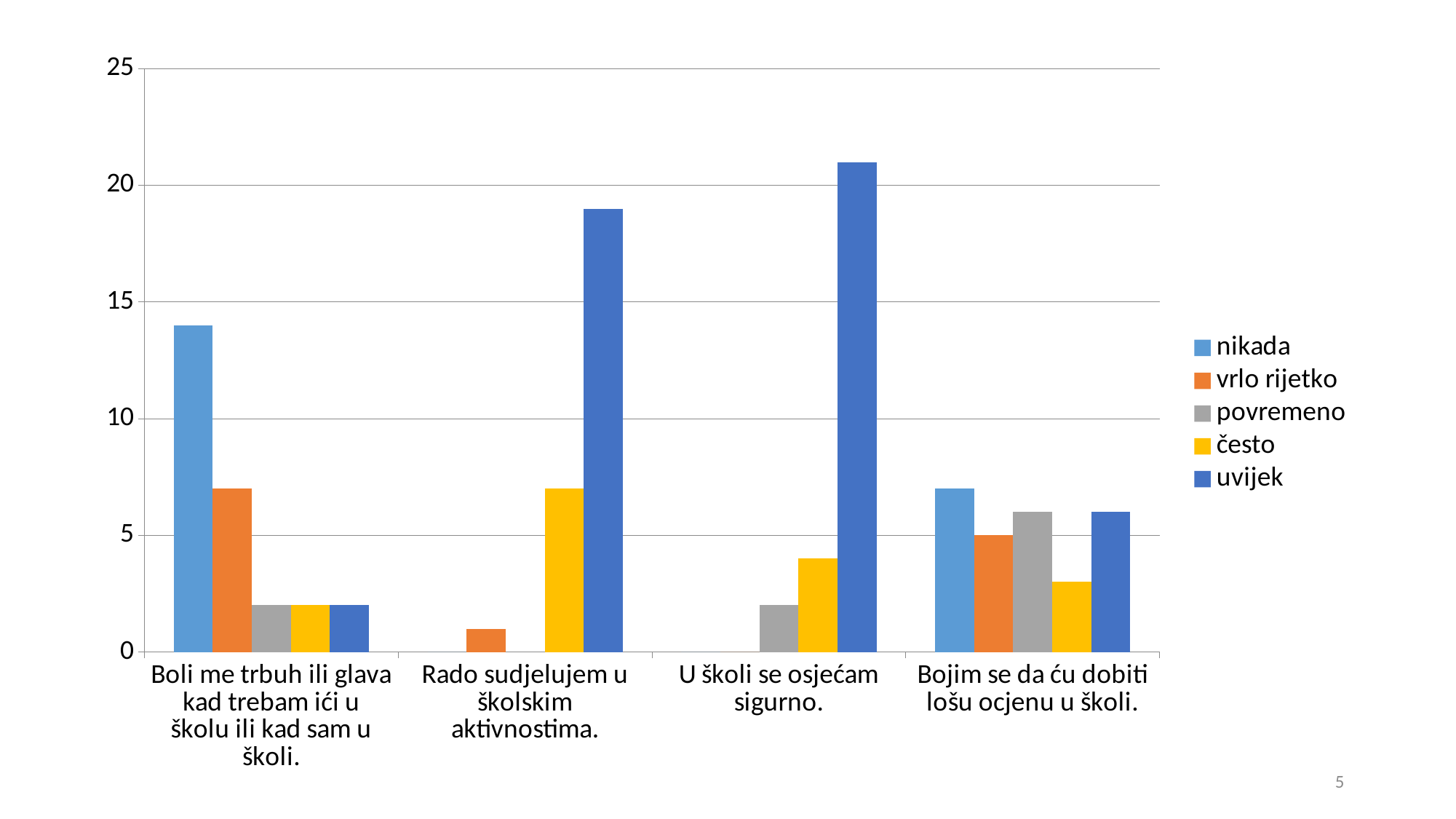
Is the value of "uvijek" for "U školi se osjećam sigurno." greater or less than 20? greater Which series has the highest value for the category "Rado sudjelujem u školskim aktivnostima."? uvijek Is the value of "uvijek" for "Rado sudjelujem u školskim aktivnostima." greater or less than 20? less How many categories are shown on the x axis? 4 What kind of chart is shown on the slide? bar chart Which series has the highest value for the category "Boli me trbuh ili glava kad trebam ići u školu ili kad sam u školi."? nikada How many series does the legend list? 5 Is the value of "nikada" for "Boli me trbuh ili glava kad trebam ići u školu ili kad sam u školi." greater or less than 10? greater Which is larger: the "uvijek" value for "U školi se osjećam sigurno." or the "uvijek" value for "Rado sudjelujem u školskim aktivnostima."? U školi se osjećam sigurno. What colour are the bars for the series "često"? yellow Which is larger for "Bojim se da ću dobiti lošu ocjenu u školi.": the value of "nikada" or the value of "često"? nikada Which category has the tallest bar in the chart? U školi se osjećam sigurno.